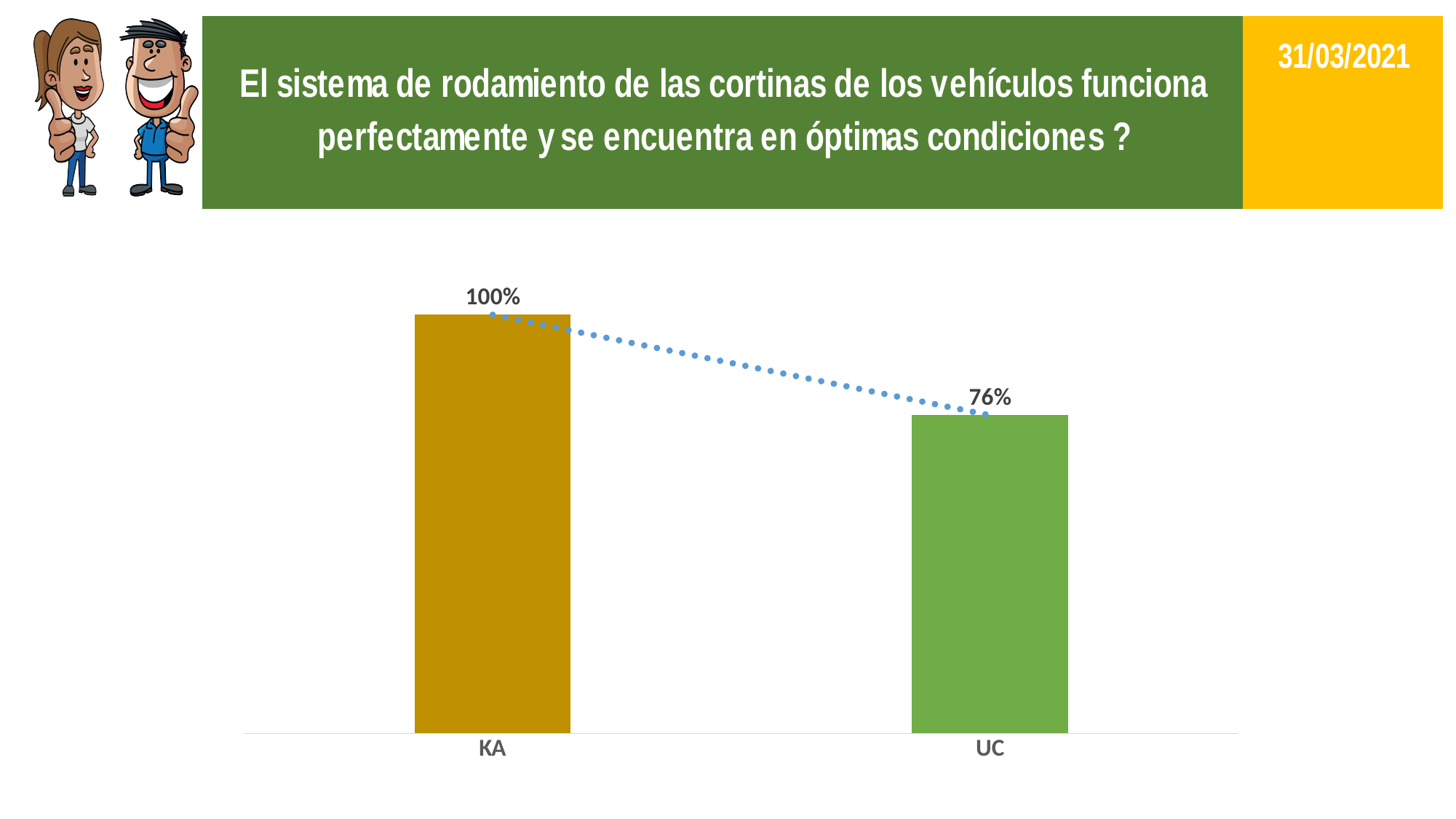
What is the value for KA? 100% What colour is the bar for KA? Gold How many categories are shown on the x axis? 2 What kind of chart is shown on the slide? Bar chart What is the difference between the values for KA and UC? 24% Which category has the highest value? KA What colour is the bar for UC? Green What is the value for UC? 76% Which is larger, the value for KA or the value for UC? KA Do the values rise or fall from KA to UC? Fall Which category has the lowest value? UC